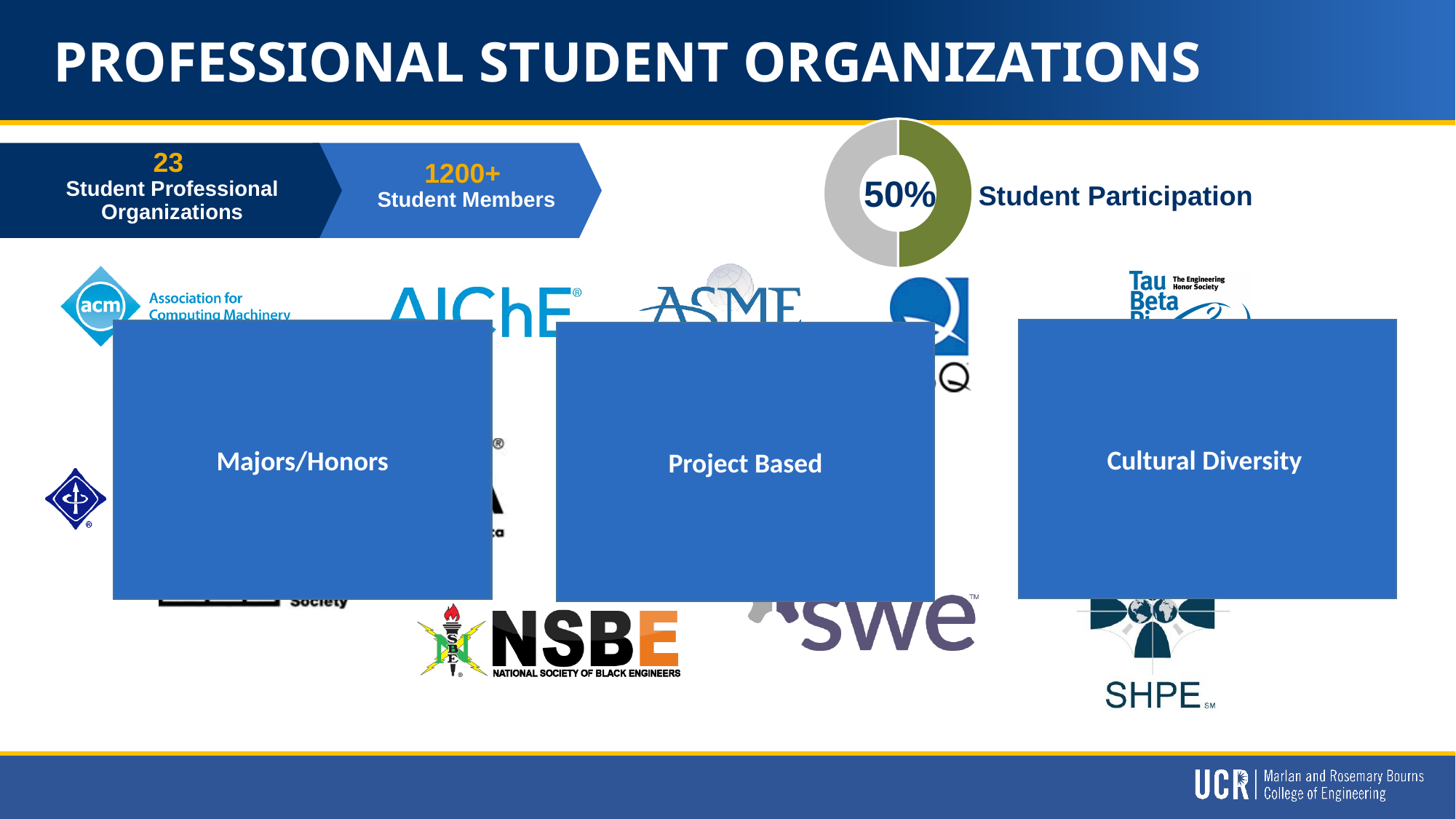
How many slices does the doughnut chart have? 2 What percentage is printed in the centre of the doughnut chart? 50% Is the student participation value shown in the doughnut chart greater or less than 25%? greater Is the student participation value shown in the doughnut chart greater or less than 75%? less What kind of chart is shown next to the 'Student Participation' label? Doughnut chart What two colours are used for the slices of the doughnut chart? Green and grey What share of the doughnut chart does the green slice represent? 50% What does the doughnut chart's 50% value represent, according to the label beside it? Student Participation